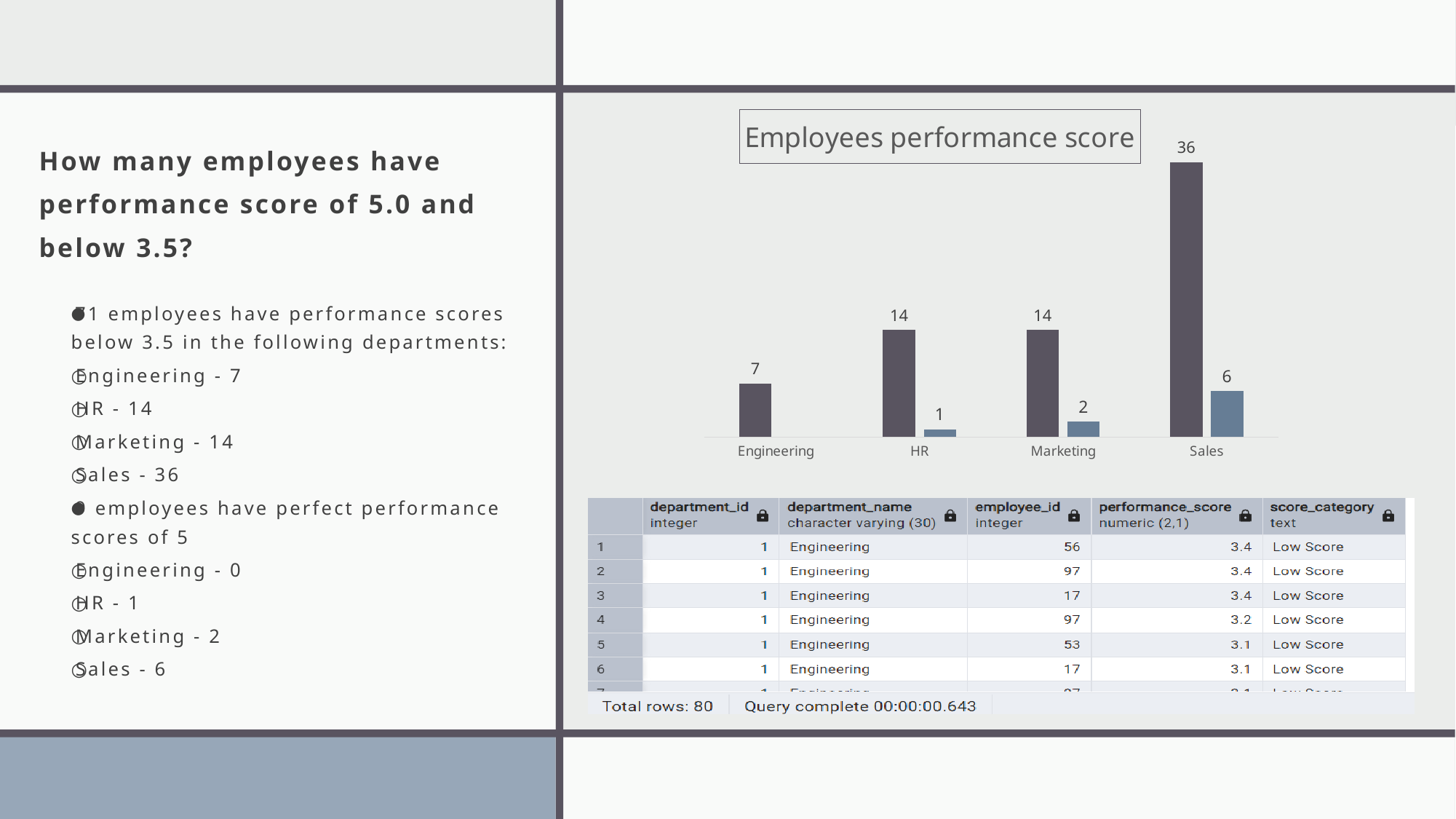
What is the combined value of the dark grey bar and the blue bar for Sales in the Employees performance score chart? 42 In the Employees performance score chart, what is the value of the blue bar for Marketing? 2 In the Employees performance score chart, which department has the tallest dark grey bar? Sales In the Employees performance score chart, what is the difference between the dark grey bar and the blue bar for Sales? 30 What type of chart is the Employees performance score chart? Bar chart In the Employees performance score chart, which department has the lowest dark grey bar? Engineering In the Employees performance score chart, what is the difference between the dark grey bar values for Sales and HR? 22 In the Employees performance score chart, what is the value of the dark grey bar for Engineering? 7 In the Employees performance score chart, what is the value of the blue bar for Sales? 6 In the Employees performance score chart, what is the value of the dark grey bar for Sales? 36 How many departments are shown on the x axis of the Employees performance score chart? 4 In the Employees performance score chart, which has the larger blue bar, HR or Marketing? Marketing